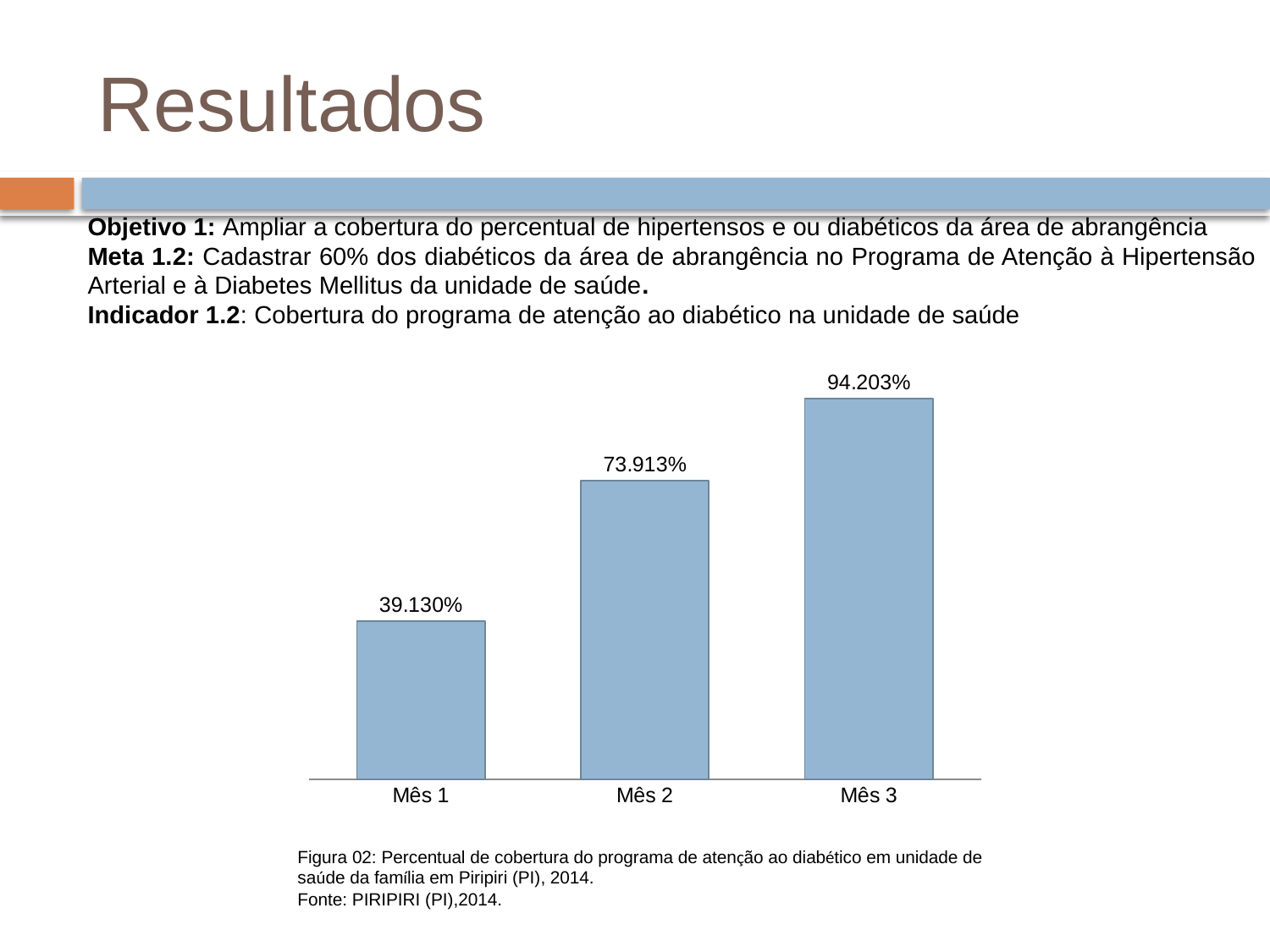
What is the value for Mês 2? 73.913% Do the values rise or fall from Mês 1 to Mês 3? Rise What is the difference between the values for Mês 2 and Mês 1? 34.783% What is the value for Mês 3? 94.203% Which month has the lowest value? Mês 1 What is the difference between the values for Mês 3 and Mês 1? 55.073% What is the value for Mês 1? 39.130% Which is larger, the value for Mês 2 or the value for Mês 3? Mês 3 Which month has the highest value? Mês 3 What kind of chart is shown on the slide? Bar chart How many months are shown in the chart? 3 What is the figure caption number given below the chart? Figura 02